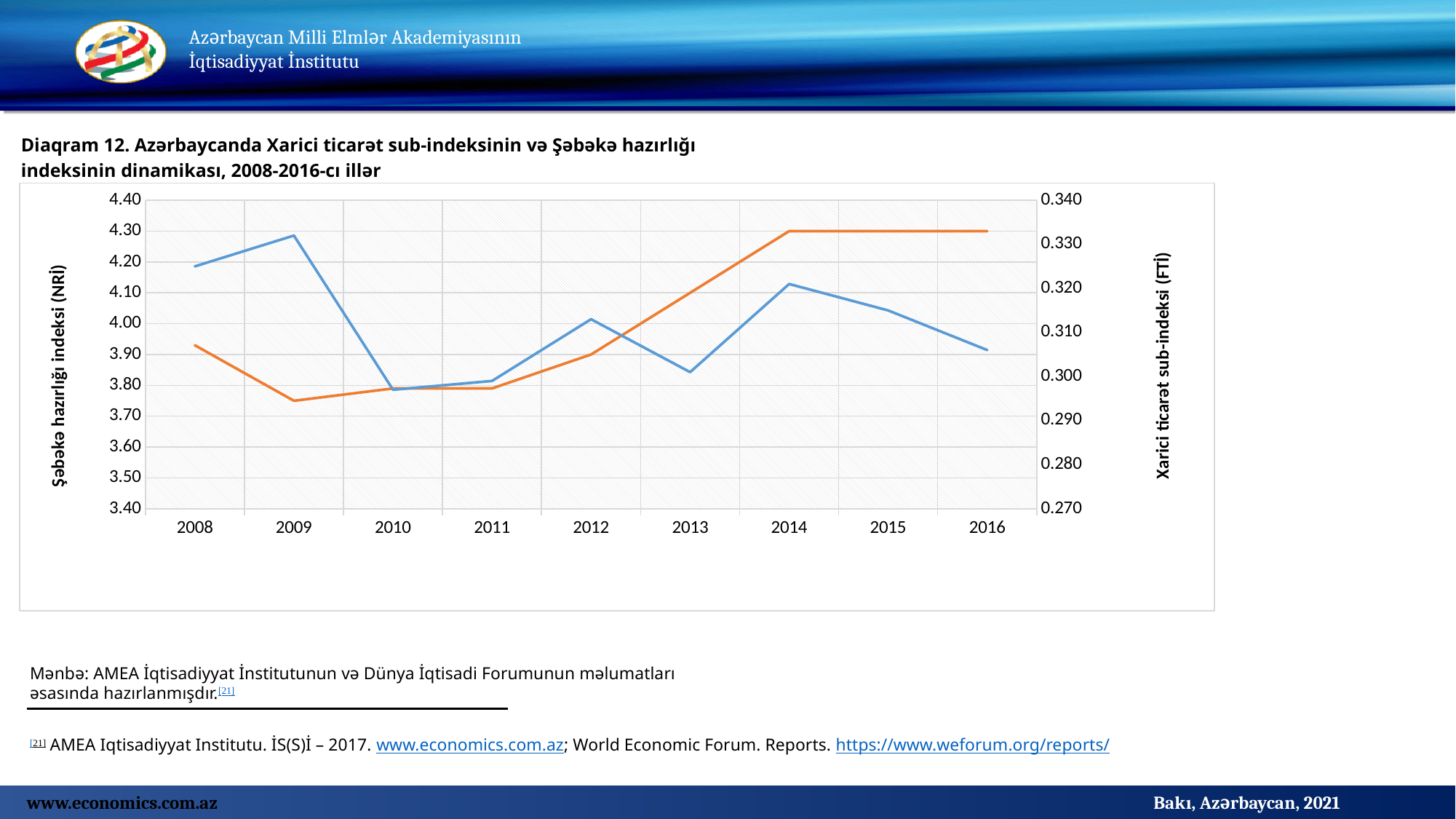
What is the title of the right-hand vertical axis of the chart? Xarici ticarət sub-indeksi (FTİ) How many years are plotted along the x axis of the chart? 9 What kind of chart is shown on the slide? line chart Is the Şəbəkə hazırlığı indeksi (NRİ) value for 2014 greater or less than 4.00? greater Does the Xarici ticarət sub-indeksi (FTİ) line rise or fall from 2011 to 2014? rise Is the Şəbəkə hazırlığı indeksi (NRİ) value for 2010 greater or less than 4.00? less